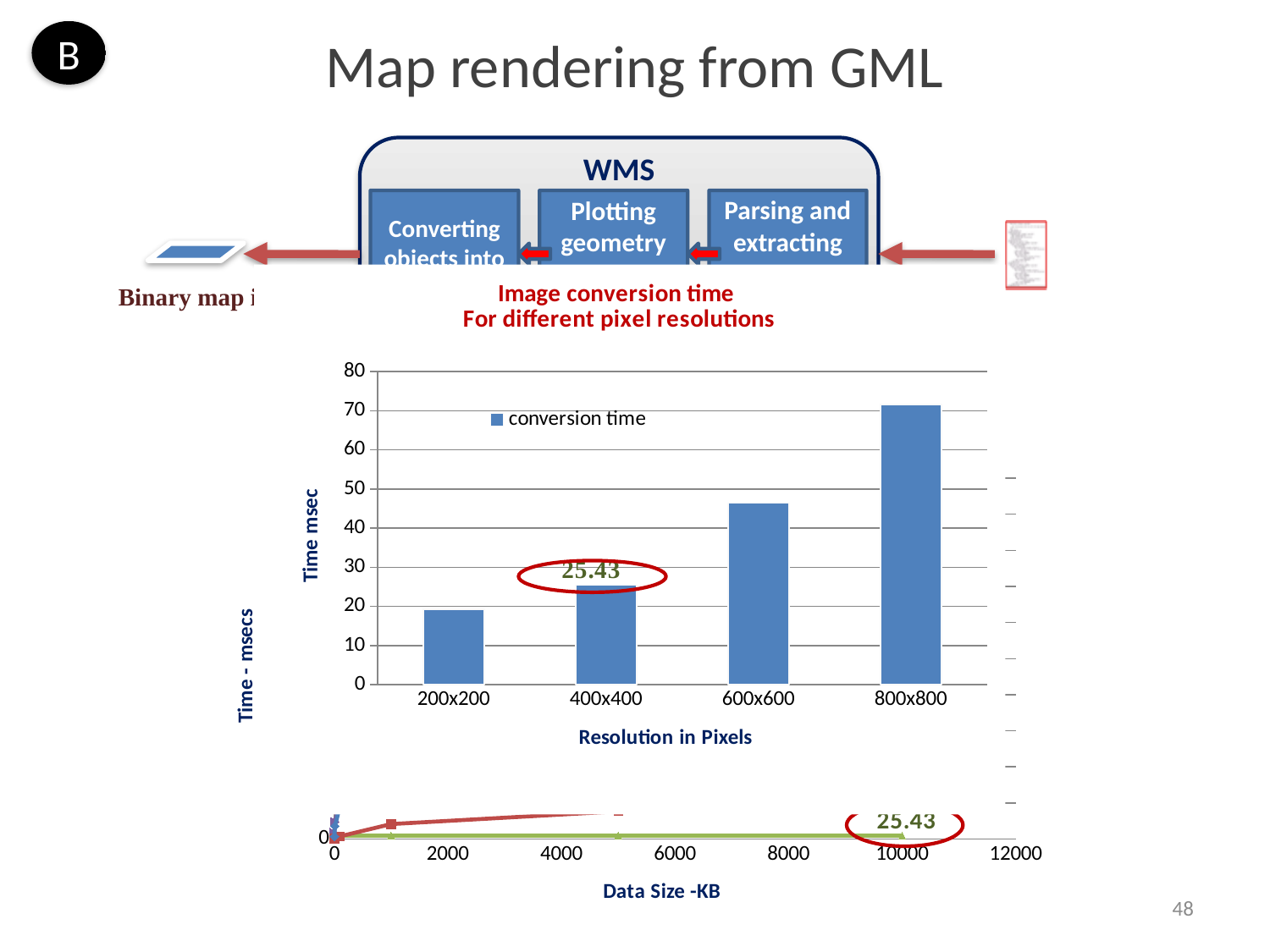
How many series does the legend of the 'Image conversion time' bar chart list? 1 What is the x-axis title of the 'Image conversion time' bar chart? Resolution in Pixels In the 'Image conversion time' bar chart, is the value for 600x600 greater or less than 40? greater What kind of chart is the 'Image conversion time For different pixel resolutions' chart? bar chart In the 'Image conversion time' bar chart, is the value for 200x200 greater or less than 30? less How many resolution categories are shown in the 'Image conversion time' bar chart? 4 In the 'Image conversion time' bar chart, what is the conversion time for the 400x400 resolution? 25.43 In the 'Image conversion time' bar chart, which has the larger conversion time, 600x600 or 400x400? 600x600 In the 'Image conversion time' bar chart, which resolution has the highest conversion time? 800x800 In the 'Image conversion time' bar chart, do the conversion times rise or fall as the resolution increases from 200x200 to 800x800? rise In the 'Image conversion time' bar chart, is the value for 800x800 greater or less than 60? greater In the 'Image conversion time' bar chart, which resolution has the lowest conversion time? 200x200